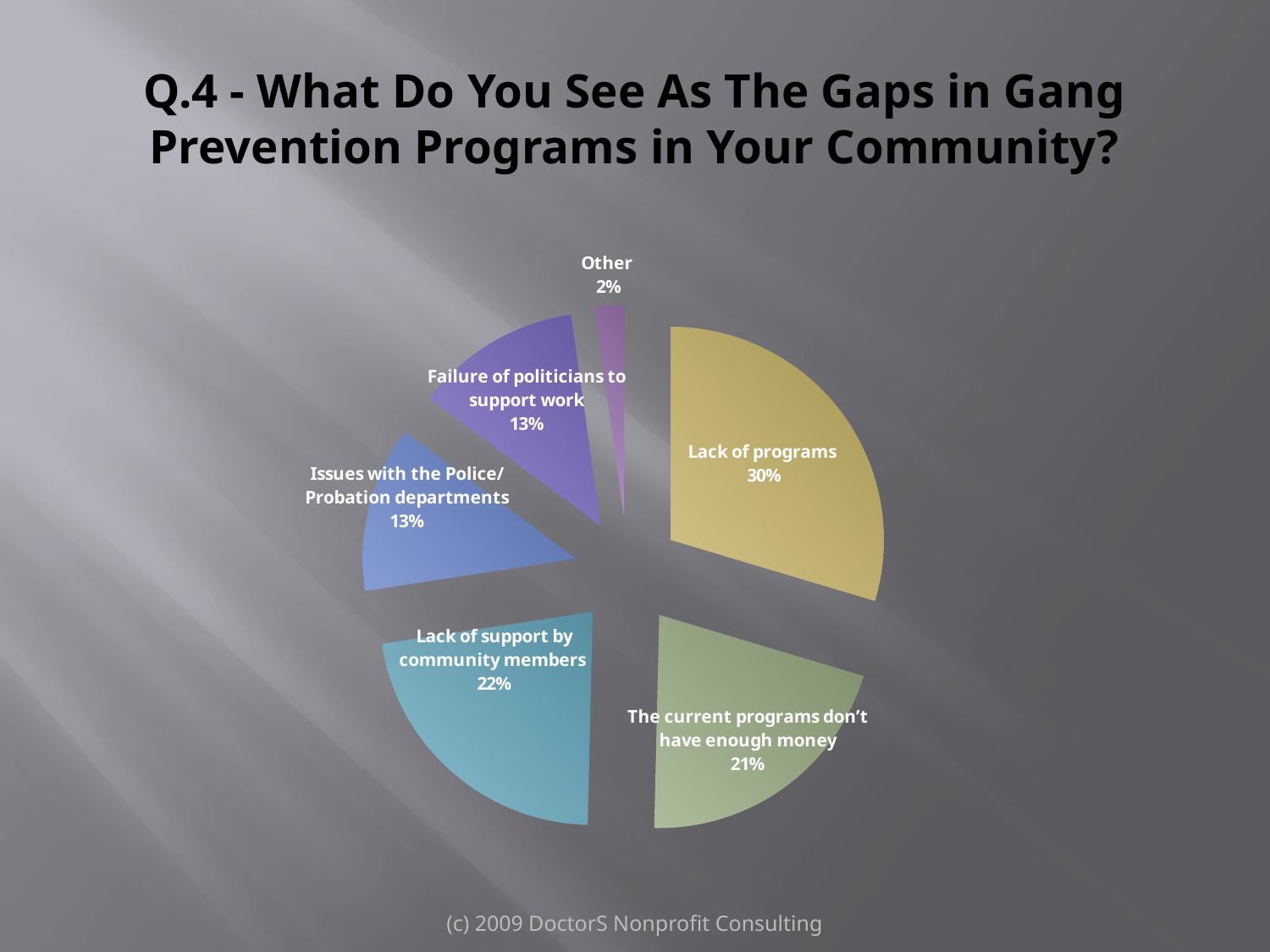
Which category has the largest share of the pie? Lack of programs What percentage is shown for 'Lack of support by community members'? 22% How many slices does the pie chart have? 6 What percentage is shown for 'Other'? 2% What is the difference in percentage points between 'Lack of programs' and 'Lack of support by community members'? 8 What kind of chart is shown on the slide? Pie chart Which category has the smallest share of the pie? Other What share of responses is 'Lack of programs'? 30% What is the title of the chart on the slide? Q.4 - What Do You See As The Gaps in Gang Prevention Programs in Your Community? Which is larger: 'Lack of programs' or 'The current programs don't have enough money'? Lack of programs What percentage is shown for 'Issues with the Police/Probation departments'? 13% What percentage is shown for 'The current programs don't have enough money'? 21%